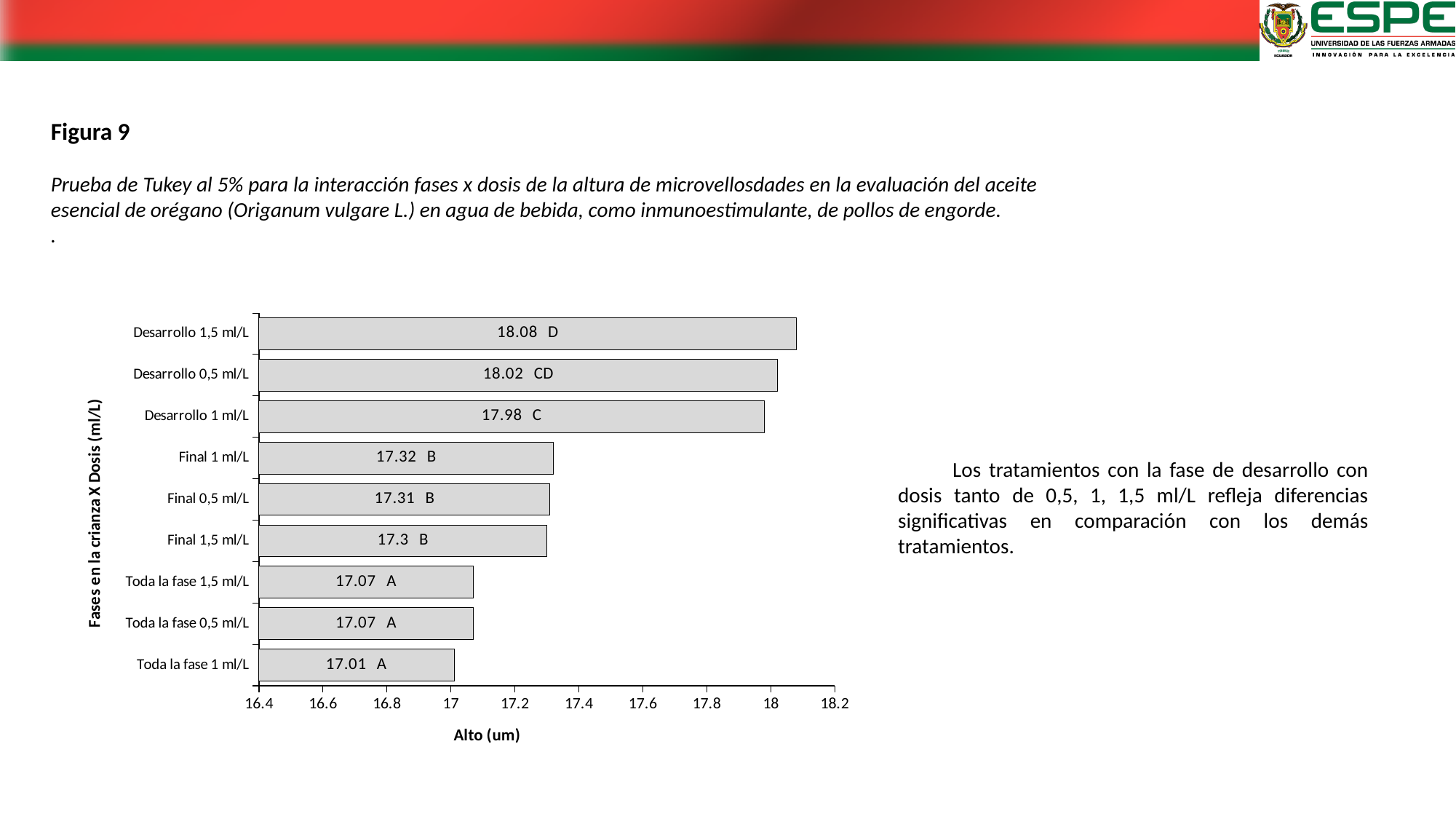
How many categories are shown on the chart? 9 What is the difference between the values for Desarrollo 1,5 ml/L and Toda la fase 1 ml/L? 1.07 What is the value for Desarrollo 1,5 ml/L? 18.08 Which category has the highest value? Desarrollo 1,5 ml/L Which is larger, the value for Desarrollo 0,5 ml/L or the value for Final 1,5 ml/L? Desarrollo 0,5 ml/L Is the value for Final 1 ml/L greater or less than 17.2? greater What kind of chart is shown on the slide? bar chart What is the difference between the values for Desarrollo 1 ml/L and Final 1 ml/L? 0.66 What is the value for Toda la fase 1 ml/L? 17.01 What is the label of the horizontal axis? Alto (um) What is the value for Final 0,5 ml/L? 17.31 Which category has the lowest value? Toda la fase 1 ml/L